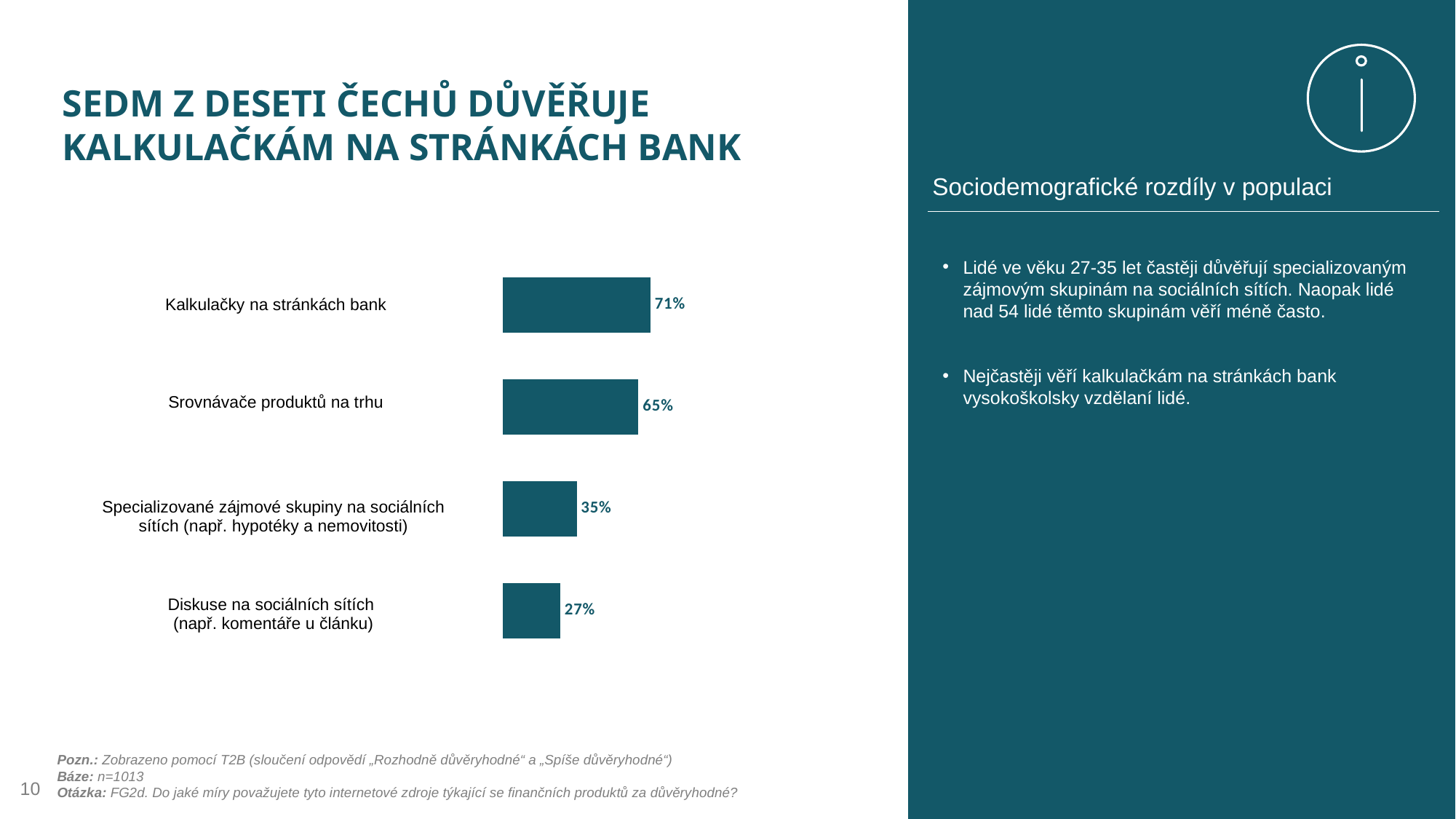
What is the base (n) stated in the note below the chart? n=1013 Which category has the highest value? Kalkulačky na stránkách bank What is the difference between the values for Specializované zájmové skupiny na sociálních sítích and Diskuse na sociálních sítích? 8% What is the value for Kalkulačky na stránkách bank? 71% How many categories does the chart show? 4 What is the value for Diskuse na sociálních sítích (např. komentáře u článku)? 27% What is the difference between the values for Kalkulačky na stránkách bank and Srovnávače produktů na trhu? 6% Which category has the lowest value? Diskuse na sociálních sítích (např. komentáře u článku) What is the value for Srovnávače produktů na trhu? 65% What kind of chart is shown on the slide? Bar chart Which is larger: the value for Srovnávače produktů na trhu or the value for Specializované zájmové skupiny na sociálních sítích? Srovnávače produktů na trhu What is the value for Specializované zájmové skupiny na sociálních sítích (např. hypotéky a nemovitosti)? 35%